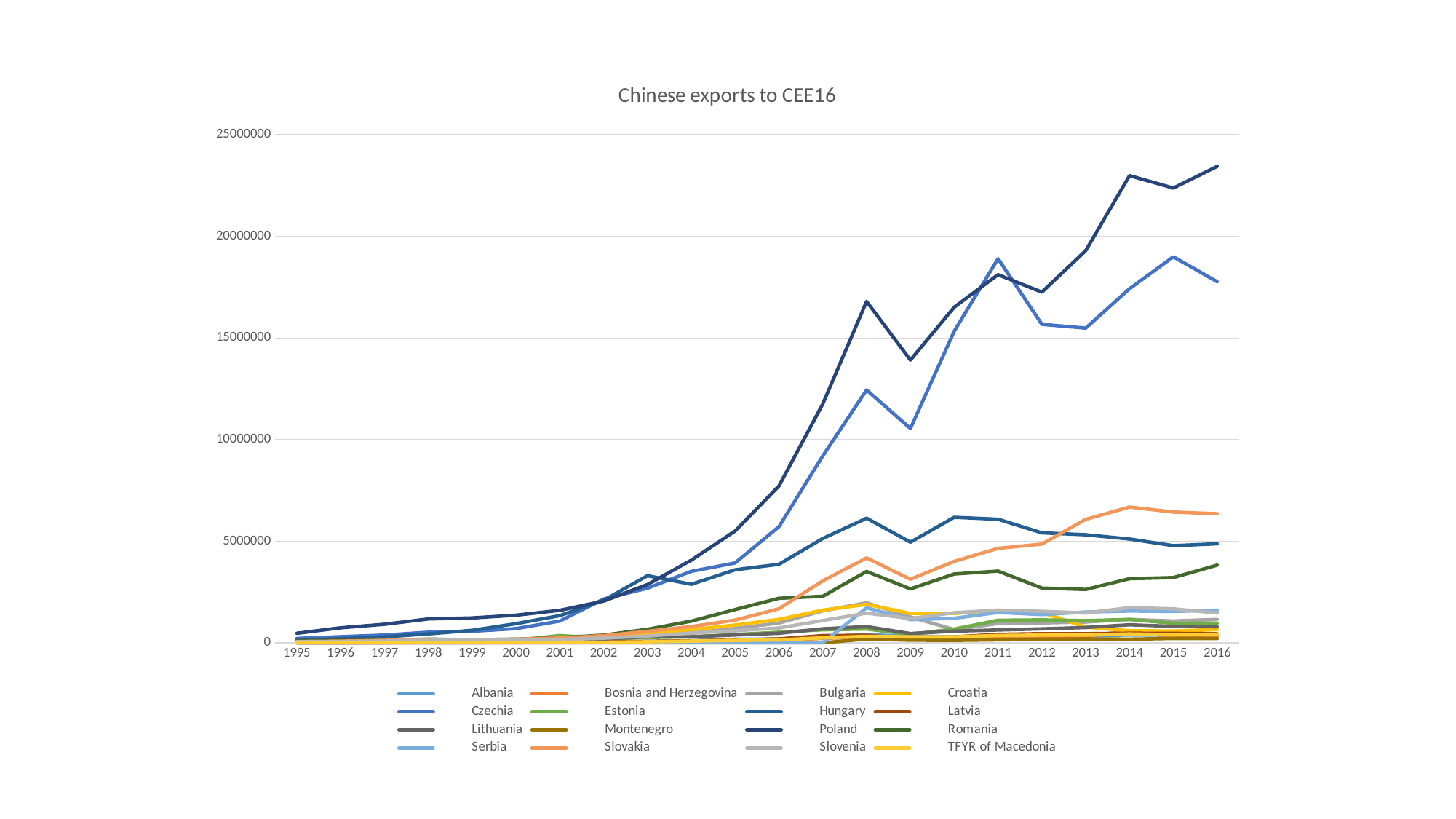
How many series does the legend list? 16 Is the value for Poland in 2008 greater or less than 15000000? greater Is the value for Slovakia in 2014 greater or less than 5000000? greater How many years are shown along the x axis? 22 Does the value for Poland generally rise or fall from 1995 to 2016? rise Is the value for Czechia in 2016 greater or less than 20000000? less Which country has the highest value in 2016? Poland Which is larger in 2016, the value for Poland or the value for Czechia? Poland What is the title of the chart? Chinese exports to CEE16 What kind of chart is shown on the slide? line chart